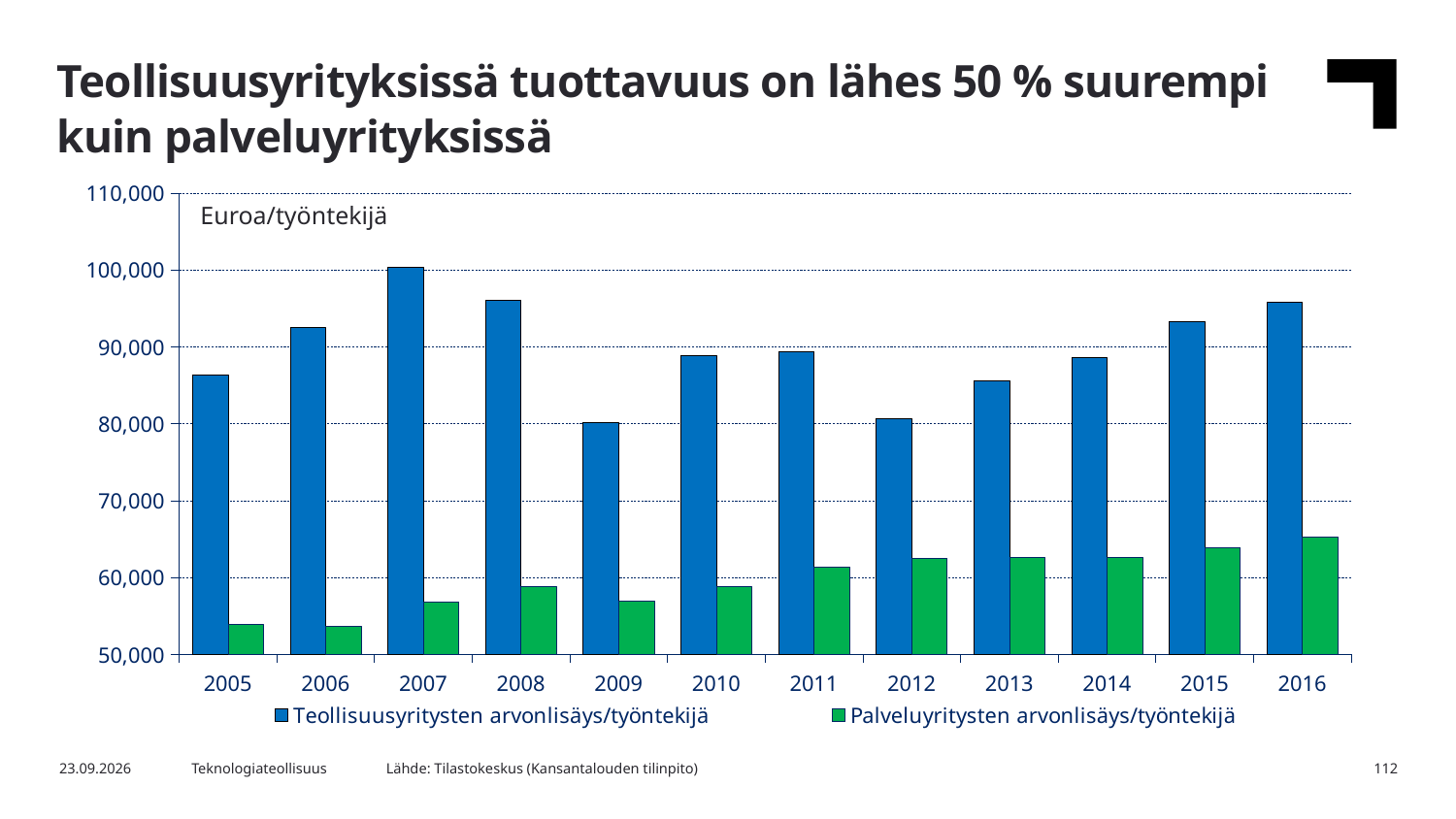
Which year has the highest value for Palveluyritysten arvonlisäys/työntekijä? 2016 Is the value for Teollisuusyritysten arvonlisäys/työntekijä in 2008 greater or less than 90,000? greater Is the value for Teollisuusyritysten arvonlisäys/työntekijä in 2012 greater or less than 90,000? less Do the values for Palveluyritysten arvonlisäys/työntekijä generally rise or fall from 2005 to 2016? rise Which is larger for Teollisuusyritysten arvonlisäys/työntekijä: 2008 or 2009? 2008 What unit label is shown inside the chart area? Euroa/työntekijä Is the value for Palveluyritysten arvonlisäys/työntekijä in 2005 greater or less than 60,000? less How many years are shown on the x axis? 12 How many series does the legend list? 2 What kind of chart is shown on the slide? bar chart Which year has the highest value for Teollisuusyritysten arvonlisäys/työntekijä? 2007